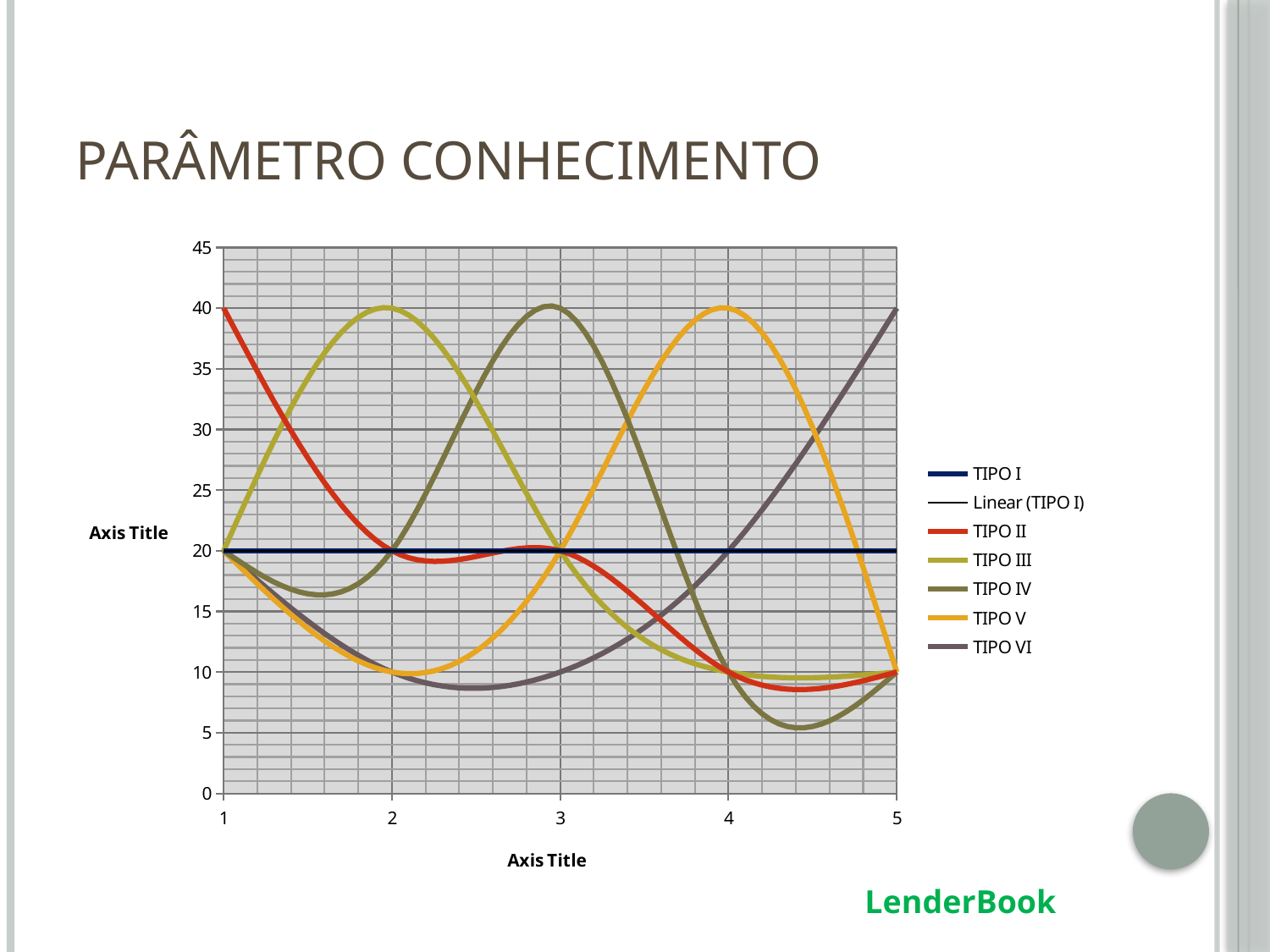
At x = 1, which is larger: TIPO II or TIPO I? TIPO II Does TIPO VI rise or fall between x = 4 and x = 5? rise Which series has the highest value at x = 3? TIPO IV How many points are labelled on the x axis? 5 What is the value of TIPO III at x = 2? 40 How many entries does the legend list? 7 What is the value of TIPO I at x = 1? 20 What is the value of TIPO VI at x = 5? 40 What is the value of TIPO V at x = 4? 40 What is the difference between TIPO III and TIPO I at x = 2? 20 What kind of chart is shown on the slide? line chart